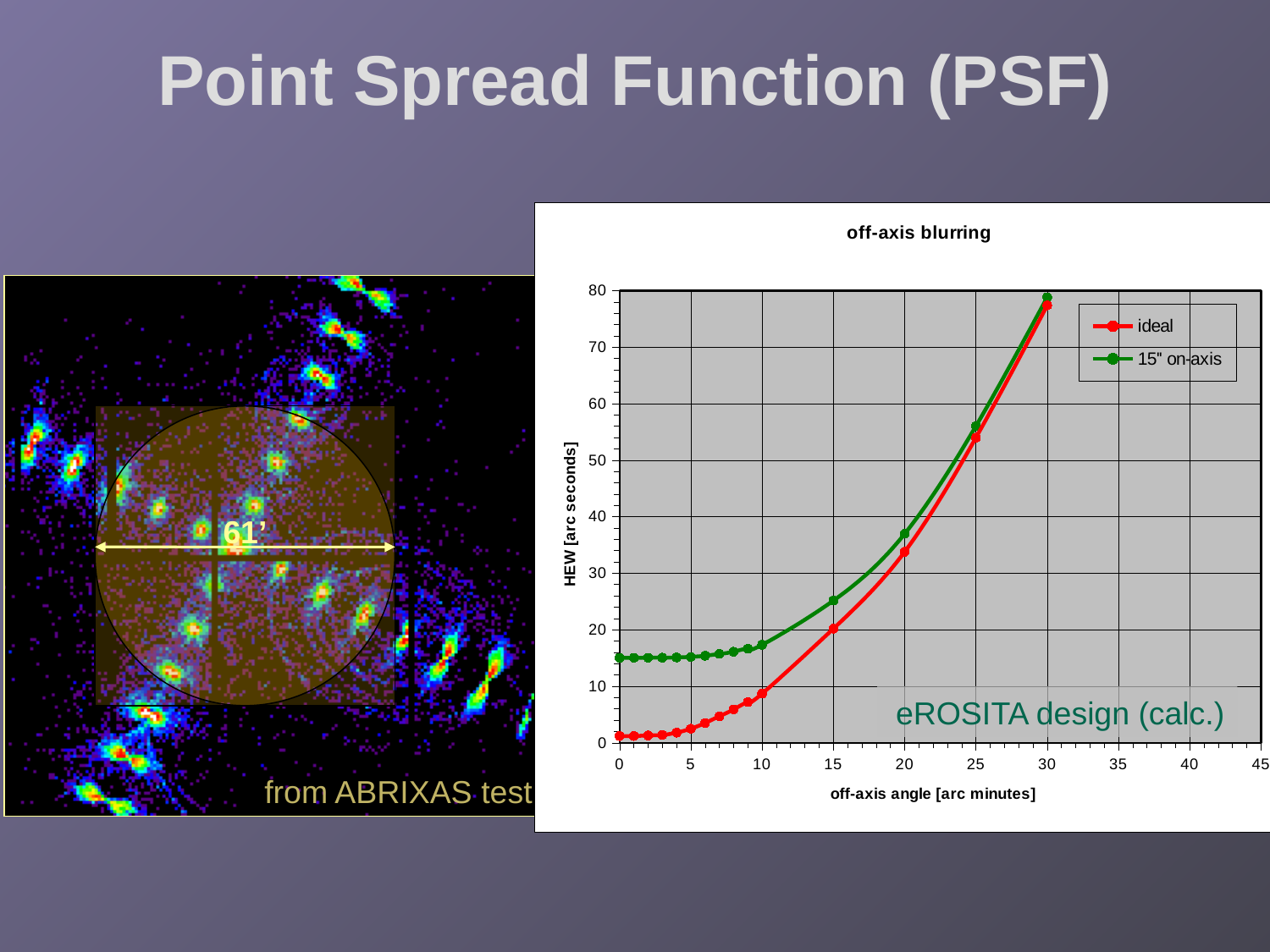
How many series does the legend of the off-axis blurring chart list? 2 What colour is the line for the 'ideal' series? red Is the value of the '15" on-axis' series at an off-axis angle of 0 arc minutes greater or less than 10? greater At an off-axis angle of 15 arc minutes, which series has the higher HEW value? 15" on-axis What is the title of the chart on the slide? off-axis blurring What kind of chart is shown on the slide? line chart Is the value of the '15" on-axis' series at an off-axis angle of 30 arc minutes greater or less than 70? greater At an off-axis angle of 5 arc minutes, which series has the lower HEW value? ideal Do the HEW values rise or fall as the off-axis angle increases? rise Is the value of the 'ideal' series at an off-axis angle of 10 arc minutes greater or less than 20? less At which off-axis angle does the 'ideal' series reach its highest plotted value? 30